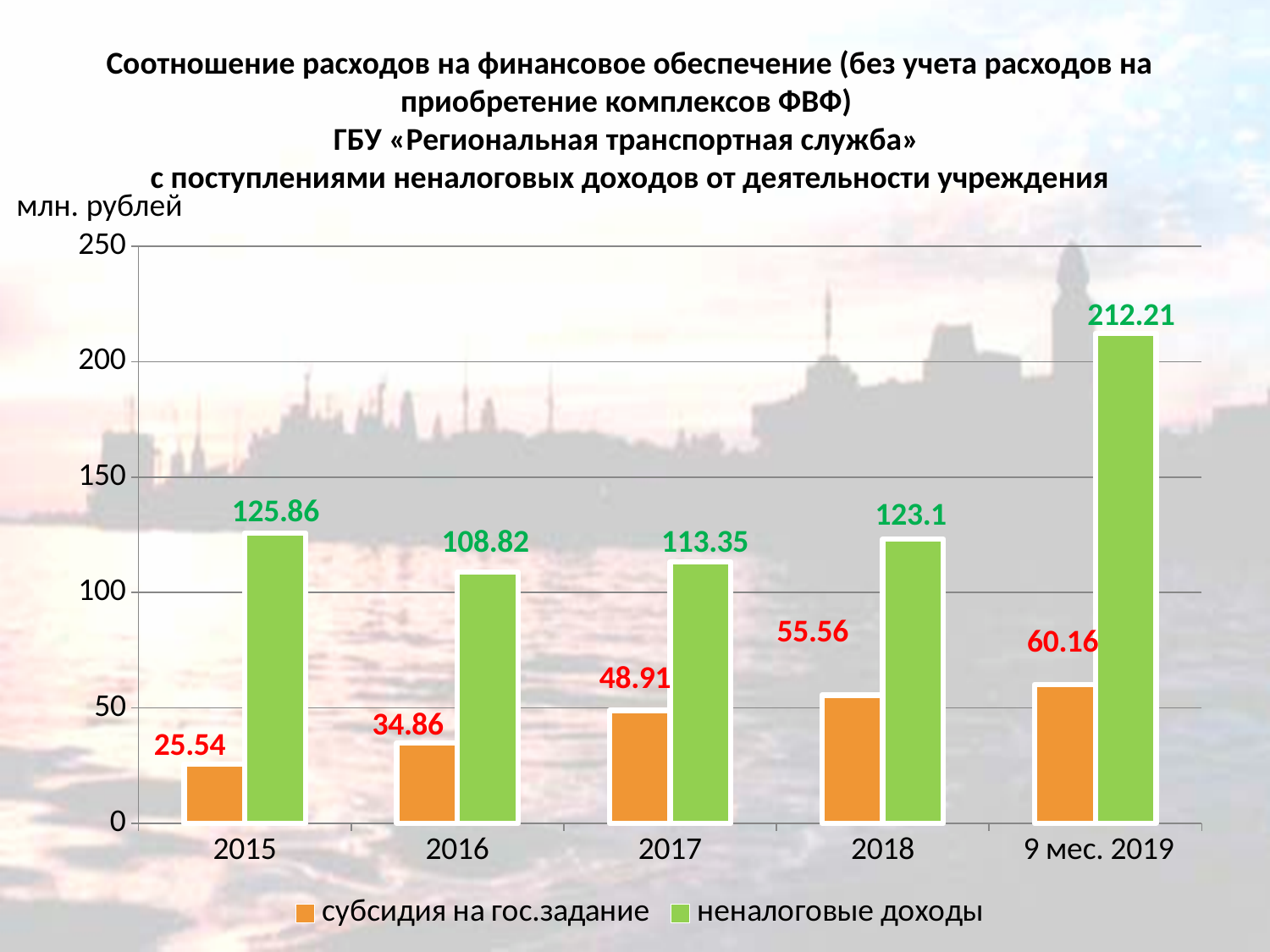
How many categories are shown on the x axis? 5 Does the value of субсидия на гос.задание rise or fall from 2015 to 9 мес. 2019? rise What kind of chart is shown on the slide? bar chart What is the value of субсидия на гос.задание for 2015? 25.54 Which is larger in 2017: субсидия на гос.задание or неналоговые доходы? неналоговые доходы Is the value of неналоговые доходы for 2015 greater or less than 100? greater How many series does the legend list? 2 What is the difference between неналоговые доходы and субсидия на гос.задание in 2018? 67.54 What is the value of неналоговые доходы for 2016? 108.82 Which category has the lowest value for субсидия на гос.задание? 2015 What is the value of неналоговые доходы for 9 мес. 2019? 212.21 Which category has the highest value for неналоговые доходы? 9 мес. 2019